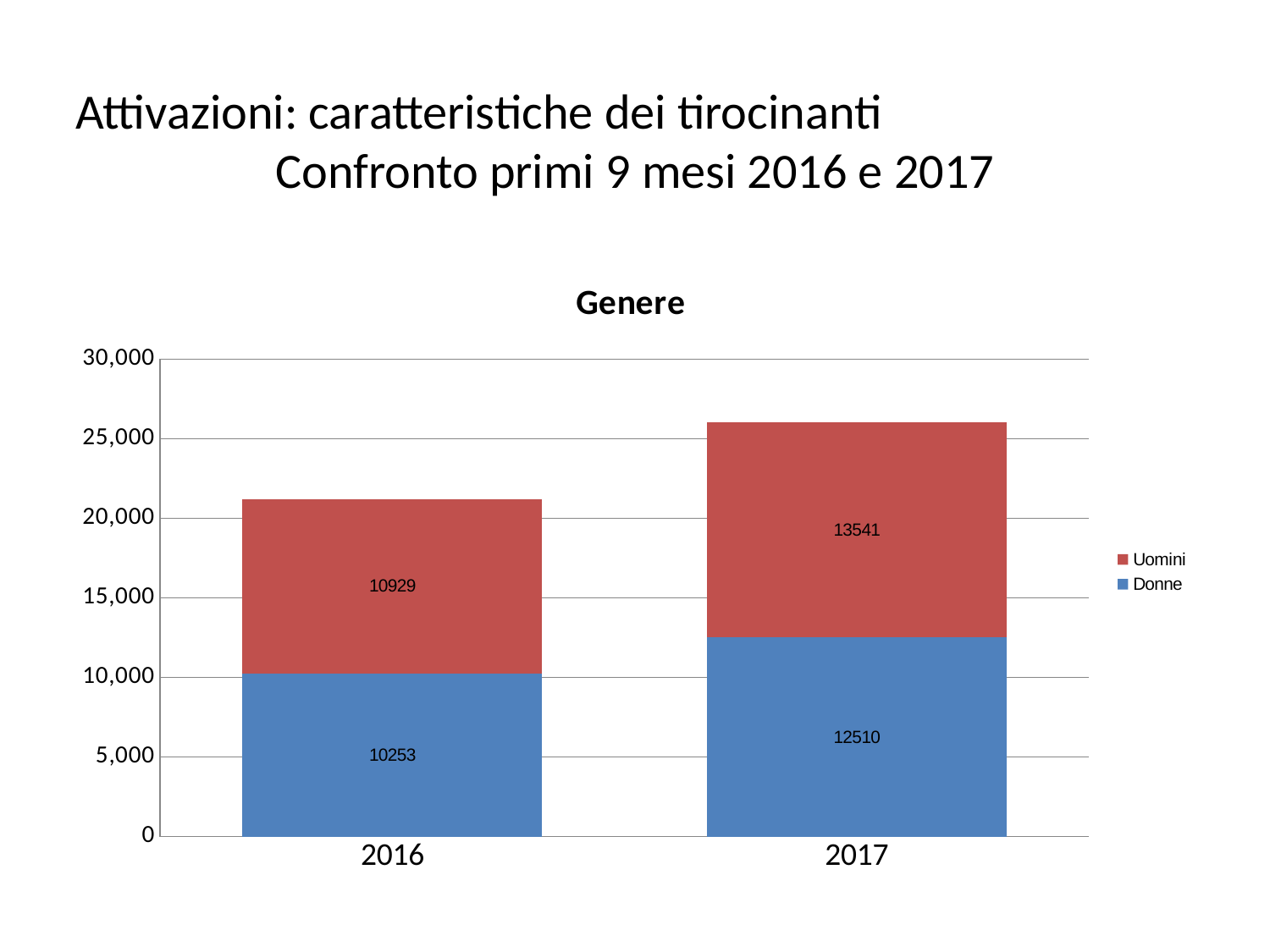
What is the difference between the Uomini values for 2017 and 2016? 2612 What is the value for Uomini in 2017? 13541 Is the total for 2017 greater or less than 25,000? greater How many series does the legend list? 2 What is the total of the stacked bar for 2016? 21182 What kind of chart is shown? Stacked bar chart What is the total of the stacked bar for 2017? 26051 What is the value for Donne in 2017? 12510 What is the title of the chart? Genere What is the value for Uomini in 2016? 10929 What is the value for Donne in 2016? 10253 Which is larger in 2017, Uomini or Donne? Uomini